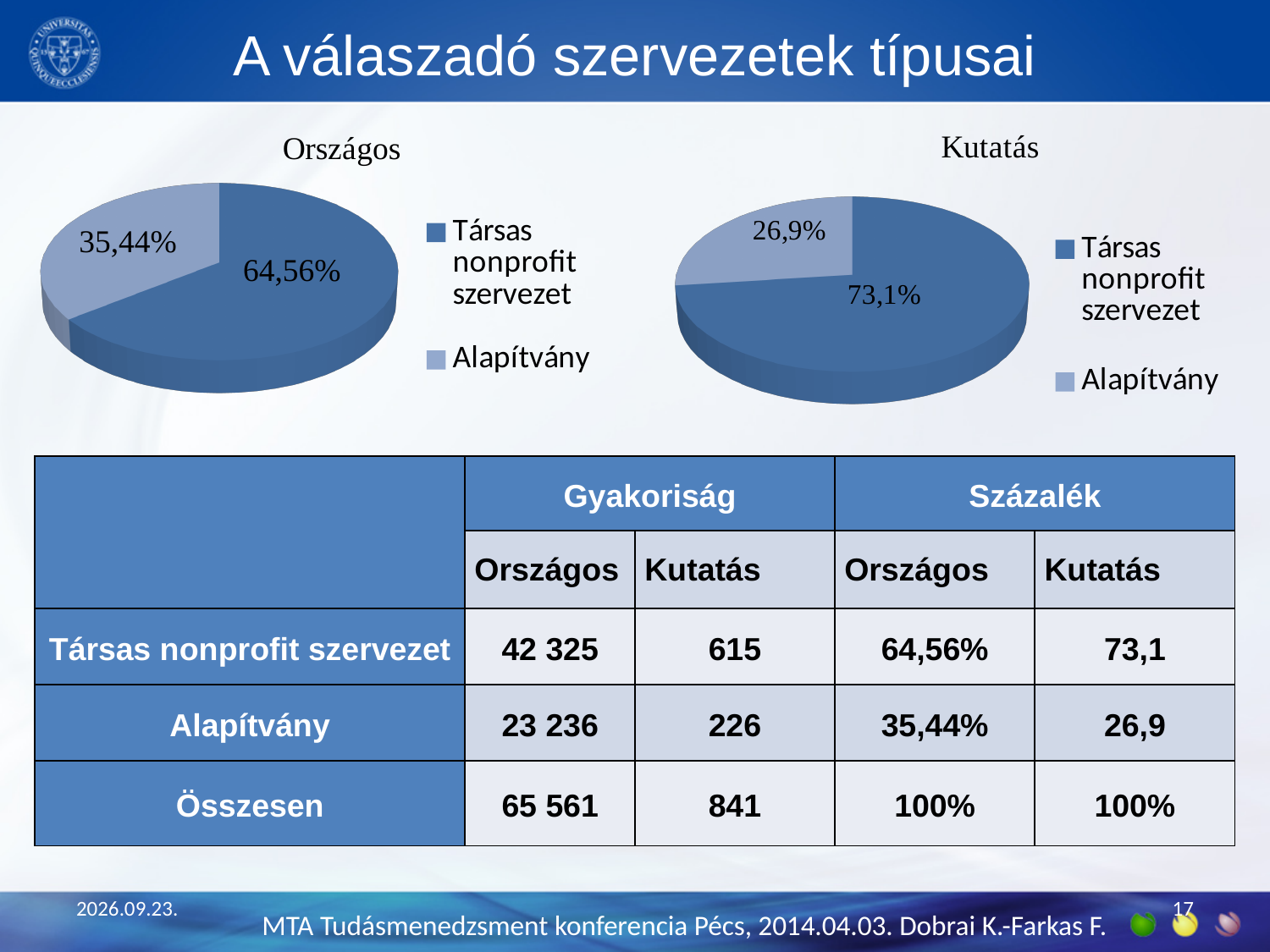
In the Országos chart, what share does Alapítvány have? 35,44% How many entries does the legend of the Kutatás chart list? 2 In the Kutatás chart, what share does Alapítvány have? 26,9% In the Kutatás chart, what is the difference between the Társas nonprofit szervezet share and the Alapítvány share? 46,2% In the Kutatás chart, what share does Társas nonprofit szervezet have? 73,1% How many slices does the Országos chart have? 2 In the Országos chart, what share does Társas nonprofit szervezet have? 64,56% In the Kutatás chart, which category has the smallest slice? Alapítvány Is the Alapítvány share larger in the Országos chart or in the Kutatás chart? Országos In the Országos chart, what is the difference between the Társas nonprofit szervezet share and the Alapítvány share? 29,12% In the Országos chart, which category has the largest slice? Társas nonprofit szervezet What type of chart is the Kutatás chart? Pie chart